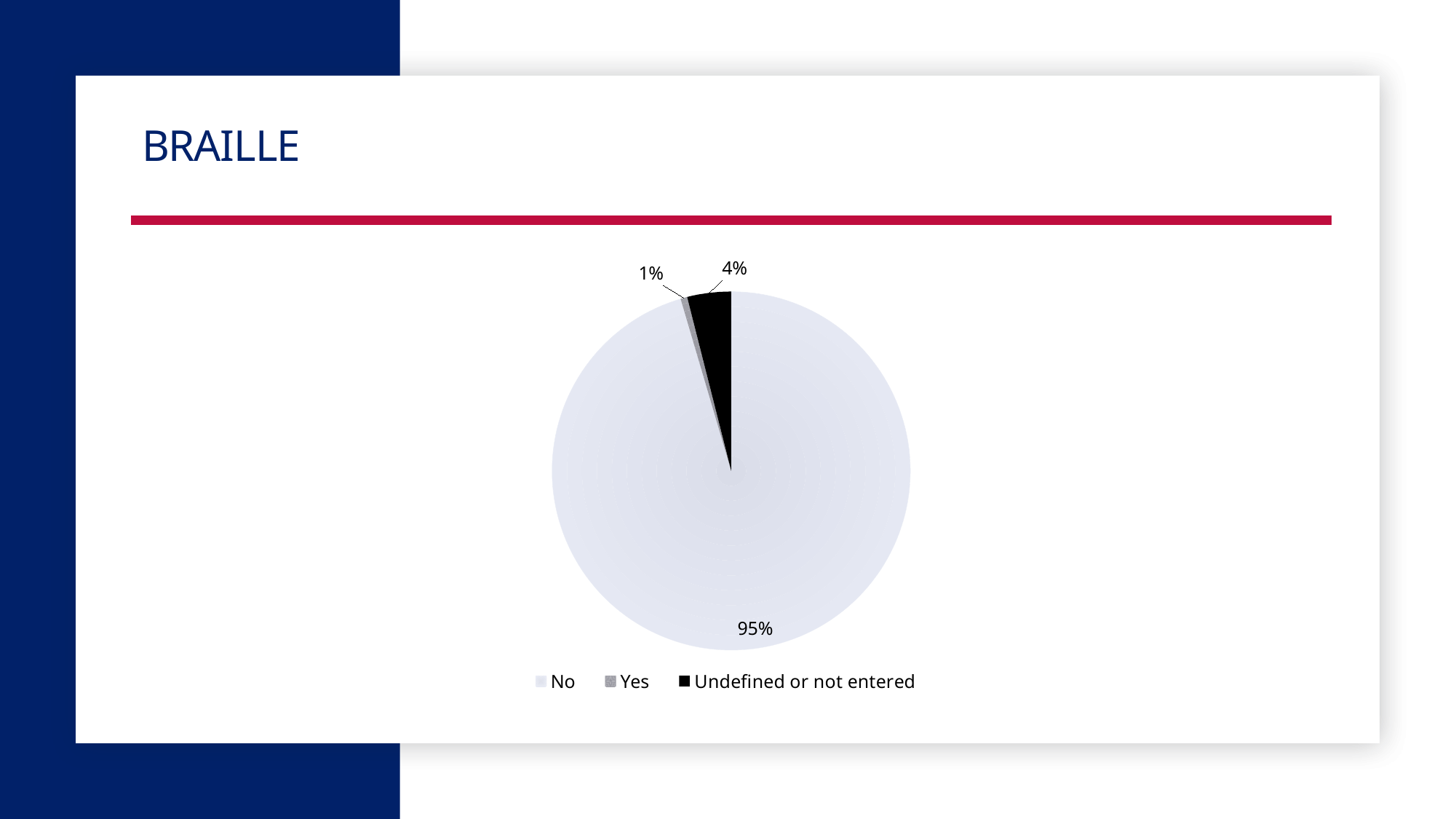
What colour is the "Undefined or not entered" slice in the pie chart? black What kind of chart is shown on the slide? pie chart Which is larger, the "Yes" slice or the "Undefined or not entered" slice? Undefined or not entered What share of the pie does the "Yes" slice represent? 1% What is the title of the slide containing the pie chart? BRAILLE What share of the pie does the "No" slice represent? 95% Which category has the largest slice of the pie? No How many categories does the pie chart have? 3 What share of the pie does the "Undefined or not entered" slice represent? 4% What is the difference in percentage points between the "Undefined or not entered" slice and the "Yes" slice? 3 What is the difference in percentage points between the "No" slice and the "Undefined or not entered" slice? 91 Which category has the smallest slice of the pie? Yes